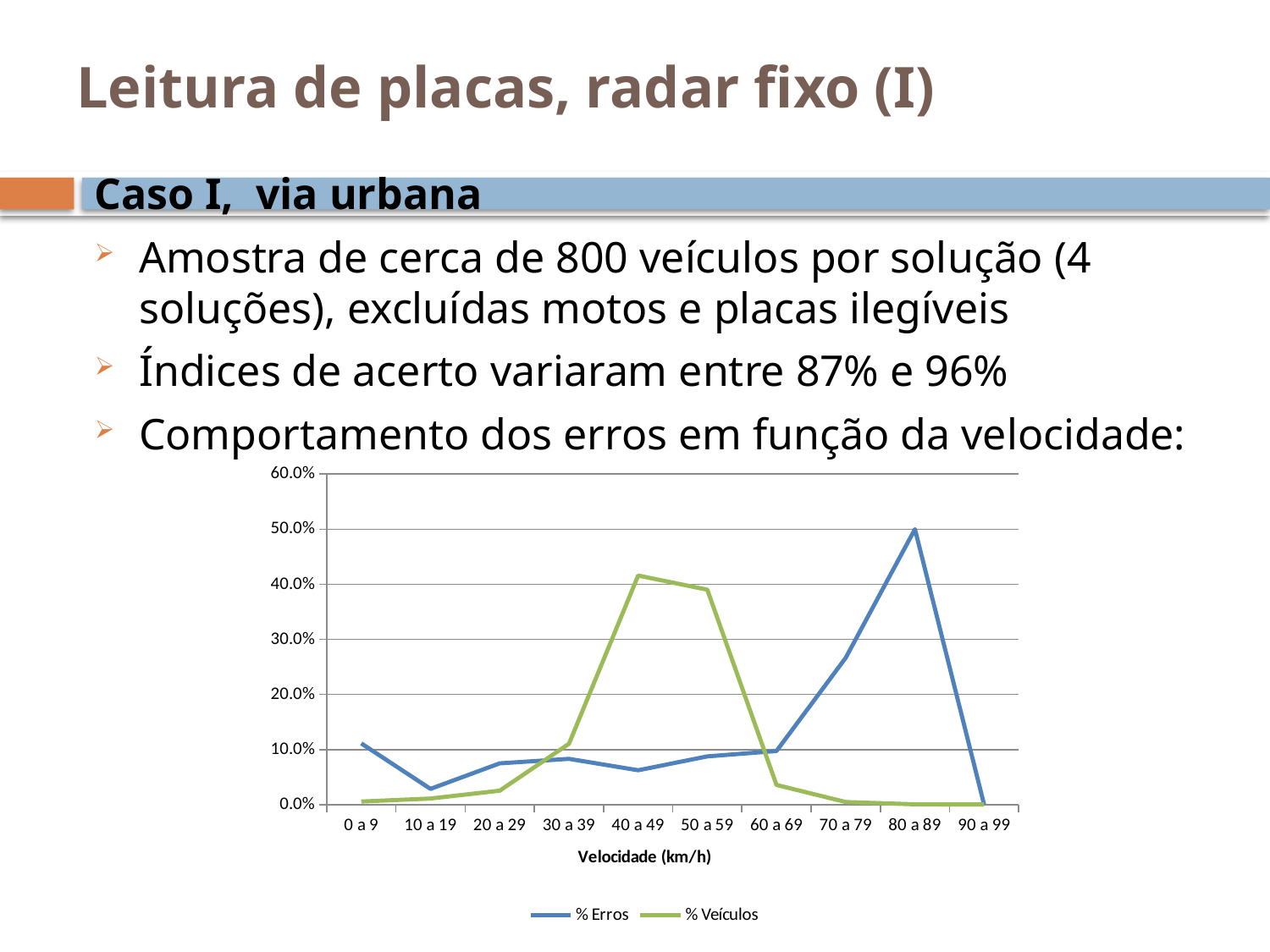
Is the value of % Erros for 10 a 19 greater or less than 10%? less What kind of chart is shown on the slide? line chart In which speed category does the % Veículos series reach its highest value? 40 a 49 How many speed categories are shown on the x axis of the chart? 10 At the 40 a 49 speed category, which series has the higher value, % Erros or % Veículos? % Veículos What is the title of the x axis of the chart? Velocidade (km/h) At the 80 a 89 speed category, which series has the higher value, % Erros or % Veículos? % Erros Is the value of % Erros for 80 a 89 greater or less than 40%? greater Is the value of % Veículos for 40 a 49 greater or less than 30%? greater How many series does the chart legend list? 2 In which speed category does the % Erros series reach its highest value? 80 a 89